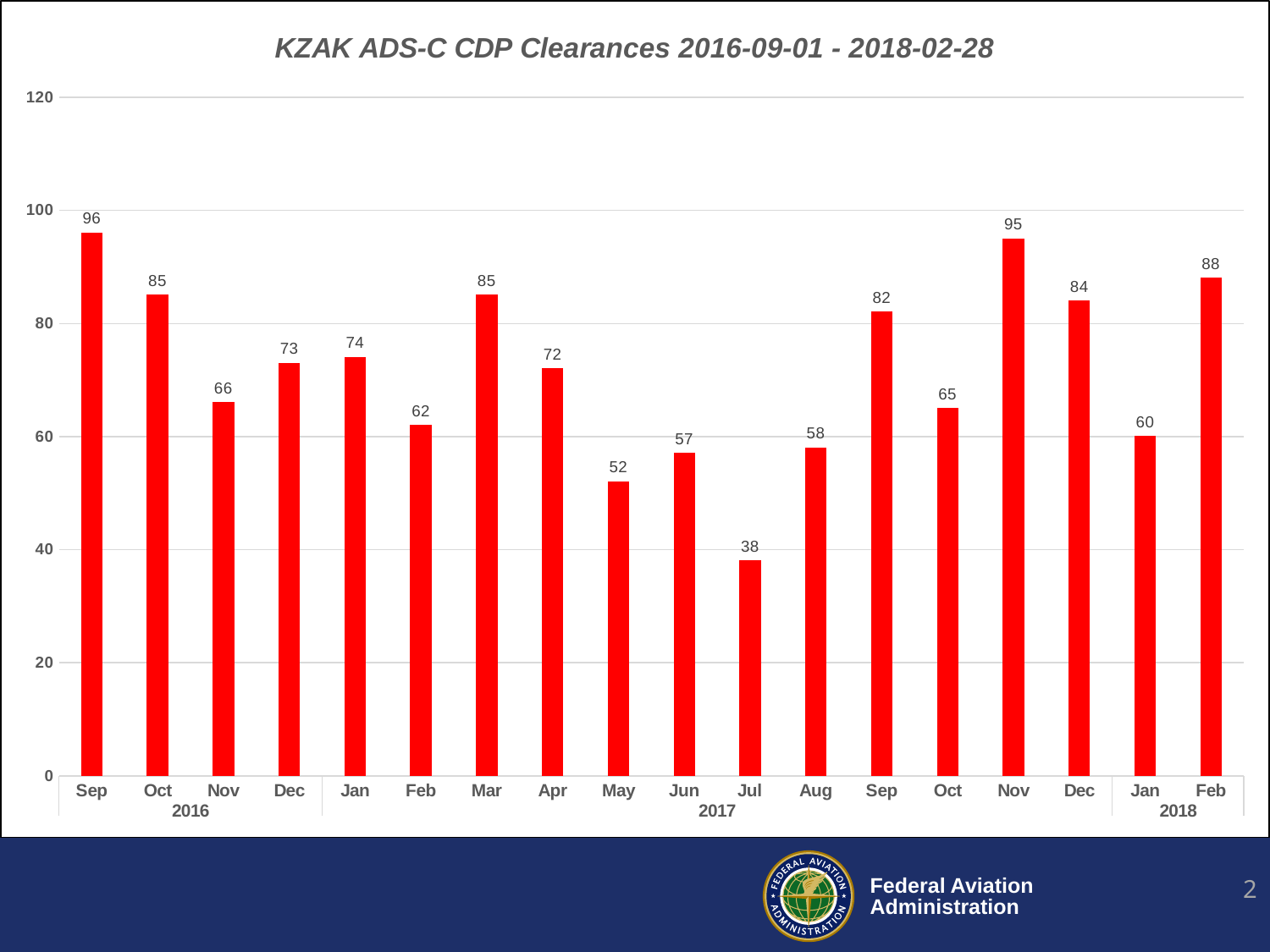
What is the value for Feb 2018? 88 How many months are plotted on the chart? 18 Which month has the highest value? Sep 2016 What is the difference between the values for Nov 2017 and Oct 2017? 30 Do the values rise or fall from Apr 2017 to Jul 2017? fall What is the title of the chart? KZAK ADS-C CDP Clearances 2016-09-01 - 2018-02-28 Which month has the lowest value? Jul 2017 What is the value for Jul 2017? 38 What kind of chart is shown? bar chart What is the value for Sep 2016? 96 Is the value for Dec 2017 greater or less than 80? greater Which is larger, the value for Mar 2017 or the value for Apr 2017? Mar 2017